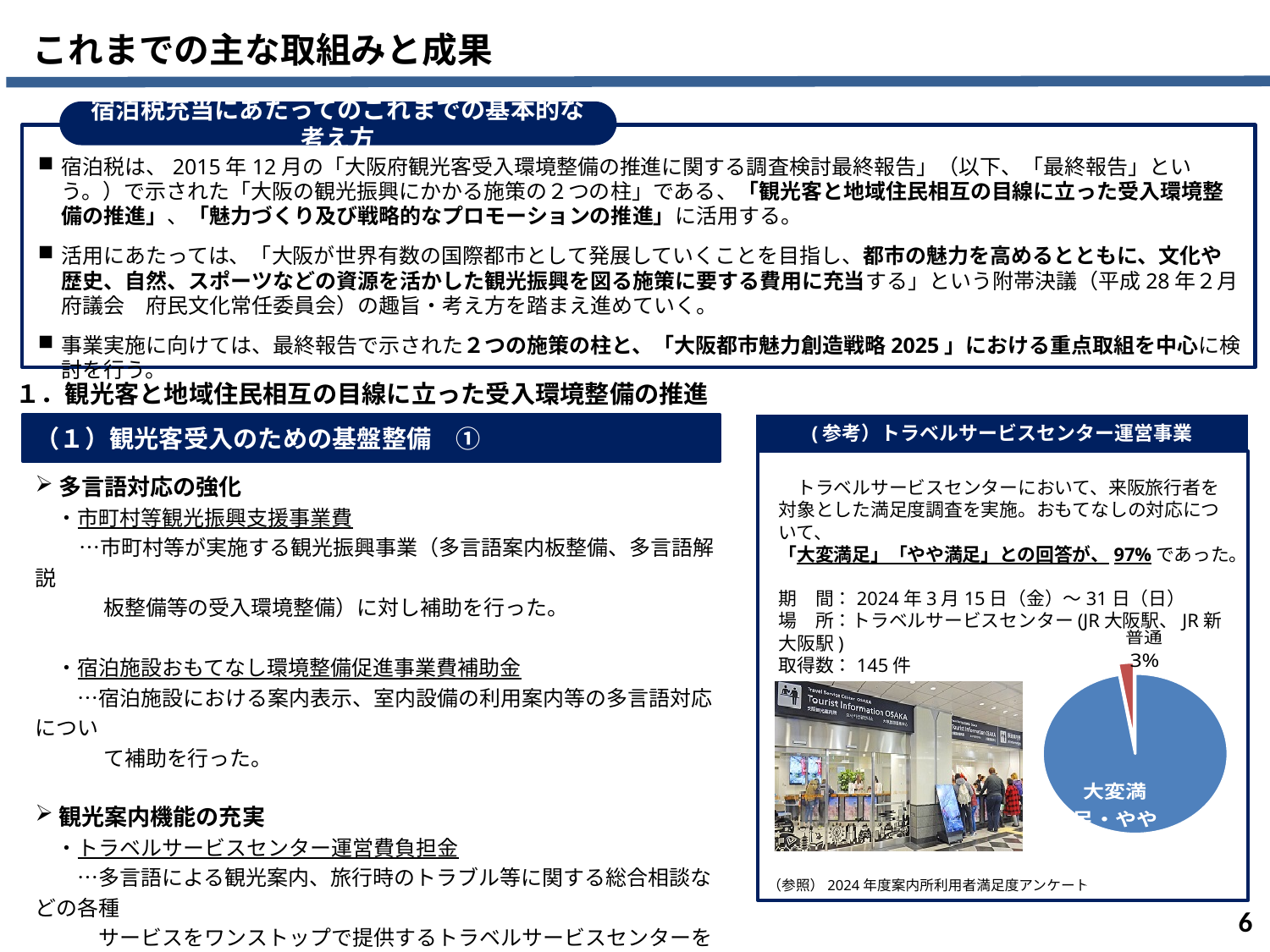
Which slice of the pie chart is the largest? 大変満足・やや満足 What share of the pie chart is labelled 普通? 3% Which is larger in the pie chart, the 普通 slice or the 大変満足・やや満足 slice? 大変満足・やや満足 What kind of chart is shown on the slide? pie chart What colour is the 大変満足・やや満足 slice in the pie chart? blue How many responses (取得数) does the survey shown next to the pie chart report? 145 件 According to the slide, what share of respondents answered 大変満足 or やや満足? 97% How many slices does the pie chart have? 2 Which slice of the pie chart is the smallest? 普通 What colour is the 普通 slice in the pie chart? red